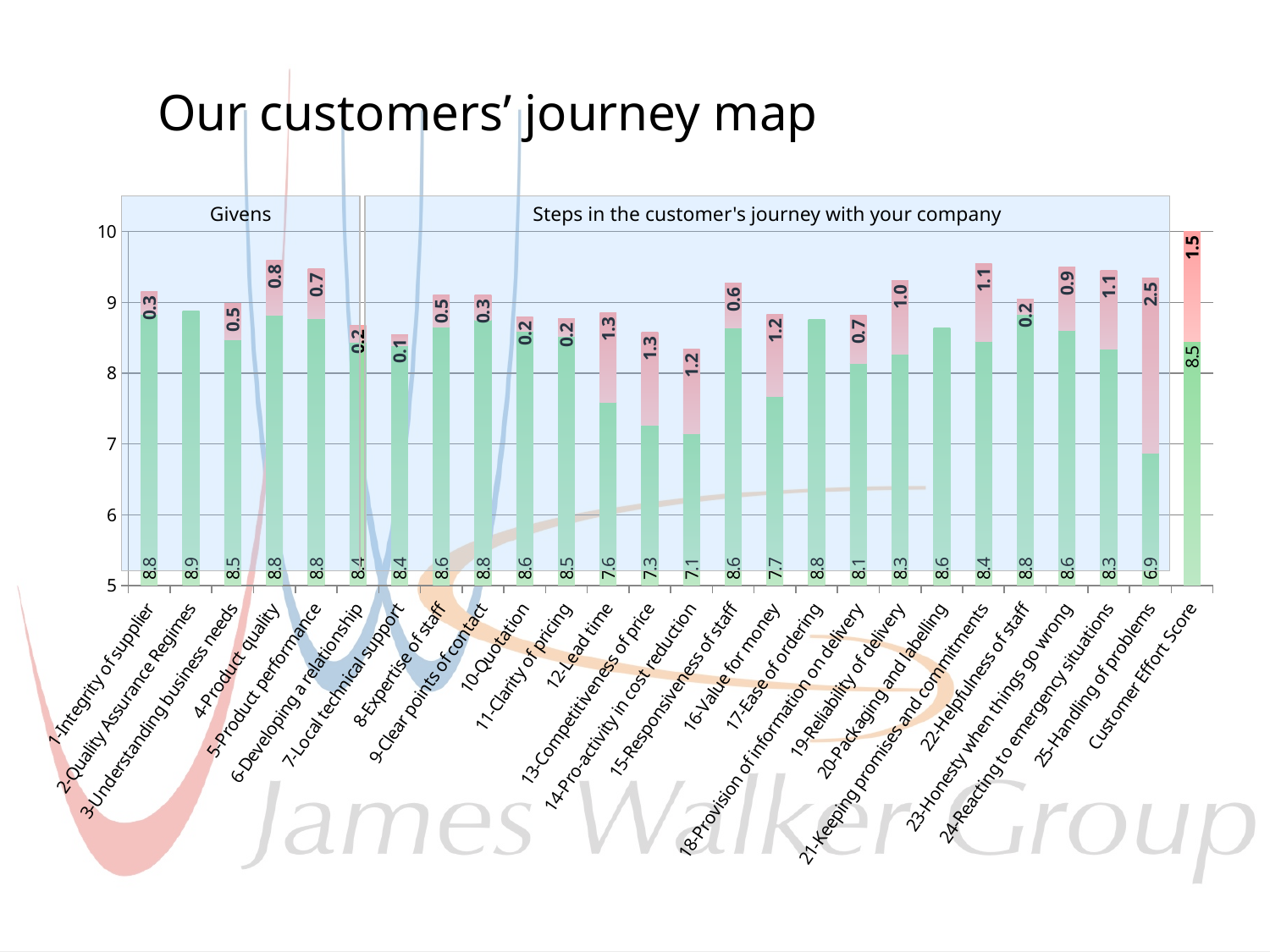
Which category has the lowest green segment value? 25-Handling of problems Which category has the largest pink segment value? 25-Handling of problems What is the difference between the green values for 2-Quality Assurance Regimes and 14-Pro-activity in cost reduction? 1.8 What is the total of the stacked bar for Customer Effort Score? 10.0 Which has a larger green value, 16-Value for money or 17-Ease of ordering? 17-Ease of ordering What is the total of the stacked bar for 25-Handling of problems? 9.4 What is the pink segment value for 12-Lead time? 1.3 What is the green segment value for 25-Handling of problems? 6.9 What are the two section headings shown above the chart? Givens; Steps in the customer's journey with your company What kind of chart is shown on the slide? Stacked bar chart What is the green segment value for Customer Effort Score? 8.5 What is the pink segment value for 19-Reliability of delivery? 1.0